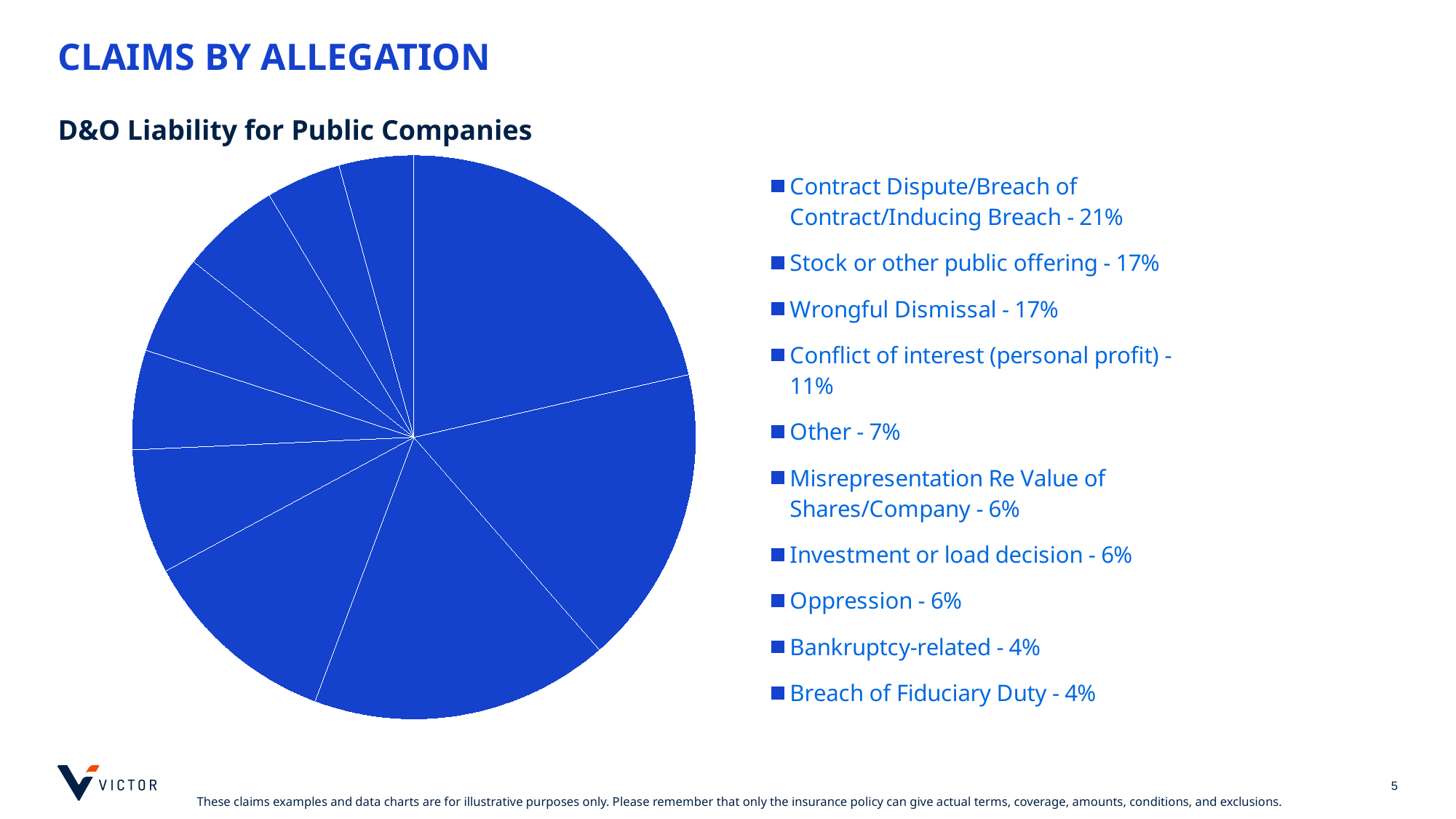
What is the title shown above the pie chart? D&O Liability for Public Companies How many allegation categories does the pie chart show? 10 What percentage of claims is for Wrongful Dismissal? 17% Which allegation category accounts for the largest share of claims? Contract Dispute/Breach of Contract/Inducing Breach What share of claims is attributed to Contract Dispute/Breach of Contract/Inducing Breach? 21% Which is larger: the share for Conflict of interest (personal profit) or the share for Other? Conflict of interest (personal profit) What share of claims is for Conflict of interest (personal profit)? 11% What percentage of claims is Bankruptcy-related? 4% Which two allegation categories each account for 6% of claims besides Oppression? Misrepresentation Re Value of Shares/Company and Investment or load decision What kind of chart is shown on the slide? pie chart What is the difference between the share for Contract Dispute/Breach of Contract/Inducing Breach and the share for Stock or other public offering? 4% What is the combined share of Stock or other public offering and Wrongful Dismissal? 34%